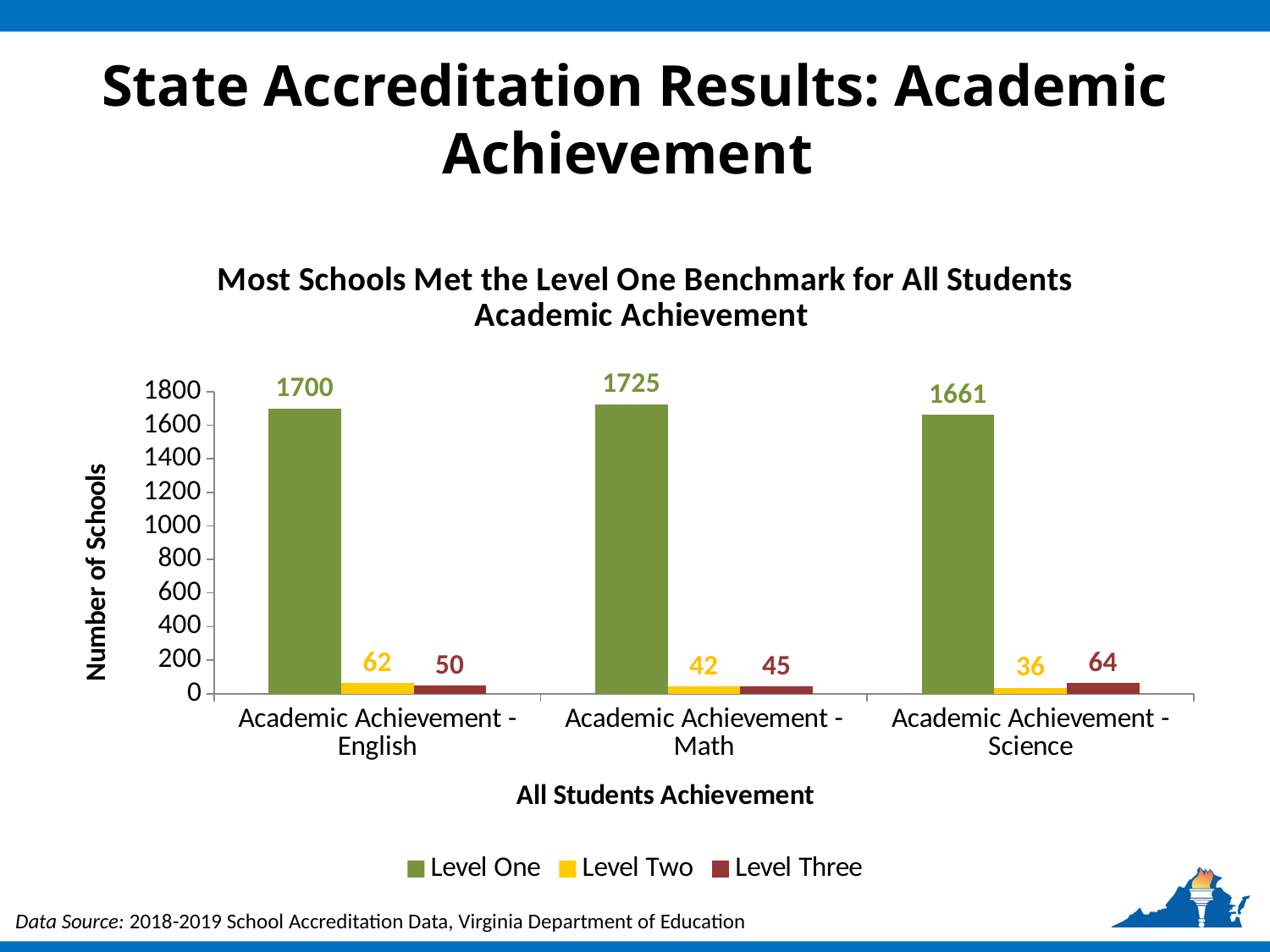
Which category has the lowest Level Two value? Academic Achievement - Science Is the Level One value for Academic Achievement - Science greater or less than 1600? greater What is the Level One value for Academic Achievement - Math? 1725 How many categories are shown on the x axis? 3 What is the label of the y axis? Number of Schools What is the Level Two value for Academic Achievement - Science? 36 What kind of chart is shown on the slide? bar chart Which category has the highest Level One value? Academic Achievement - Math What is the Level Three value for Academic Achievement - English? 50 What is the difference between the Level One values for Academic Achievement - Math and Academic Achievement - Science? 64 Which is larger: the Level Two value for Academic Achievement - English or the Level Three value for Academic Achievement - English? Level Two (62) How many series does the legend list? 3